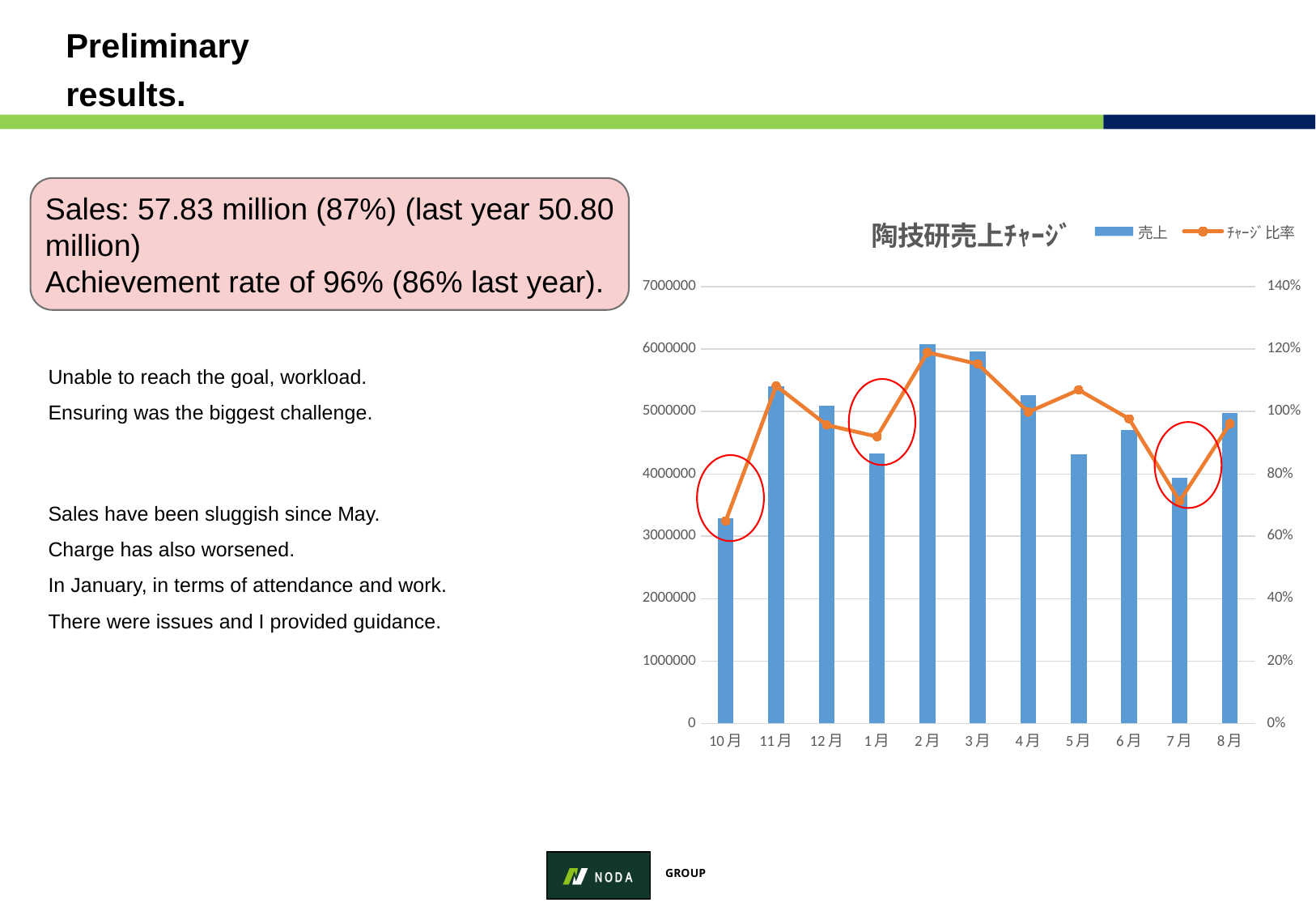
Is the 売上 value for 11月 greater or less than 5000000? greater Is the チャージ比率 value for 7月 greater or less than 80%? less What is the title of the chart? 陶技研売上ﾁｬｰｼﾞ What kind of chart is shown on the slide? Combination bar and line chart Is the 売上 value for 10月 greater or less than 4000000? less Which month has the lowest 売上 bar? 10月 Which month has the larger 売上 bar, 2月 or 5月? 2月 How many months are shown on the x axis of the chart? 11 Which month has the lowest チャージ比率 point on the line? 10月 How many series does the chart legend list? 2